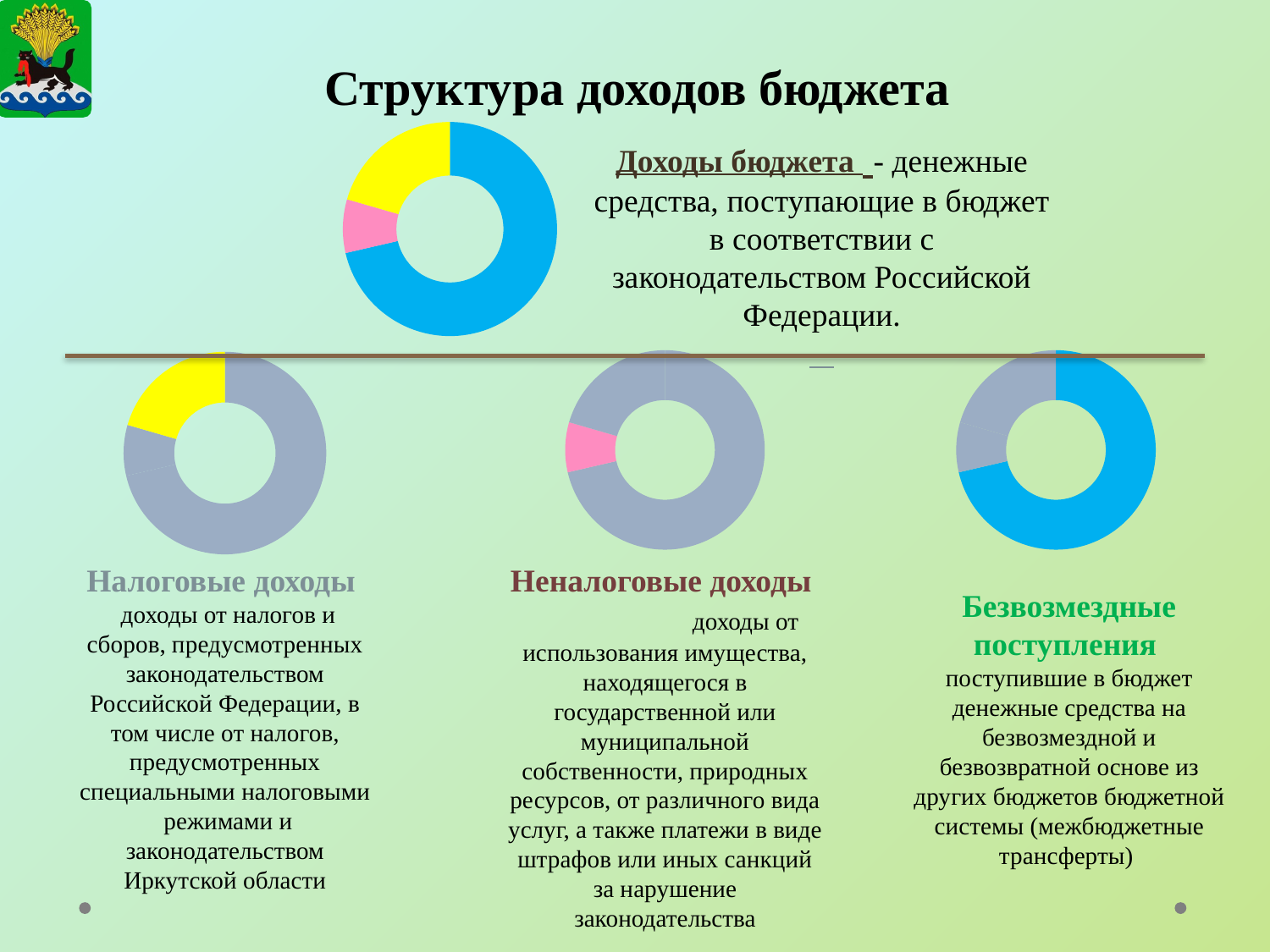
In the top chart on the slide, which slice is larger, the yellow one or the pink one? yellow How many slices does the top chart on the slide have? 3 In the top chart on the slide, which slice is larger, the blue one or the yellow one? blue What kind of chart is the chart at the top of the slide, next to the definition of 'Доходы бюджета'? pie chart (donut) In the chart above 'Налоговые доходы', is the highlighted yellow slice larger or smaller than the grey remainder? smaller In the chart above 'Неналоговые доходы', which colour is the highlighted slice? pink How many pie (donut) charts are shown on the slide in total? 4 What is the title of the slide containing the charts? Структура доходов бюджета In the top chart on the slide, which colour slice is the largest? blue In the top chart on the slide, which colour slice is the smallest? pink